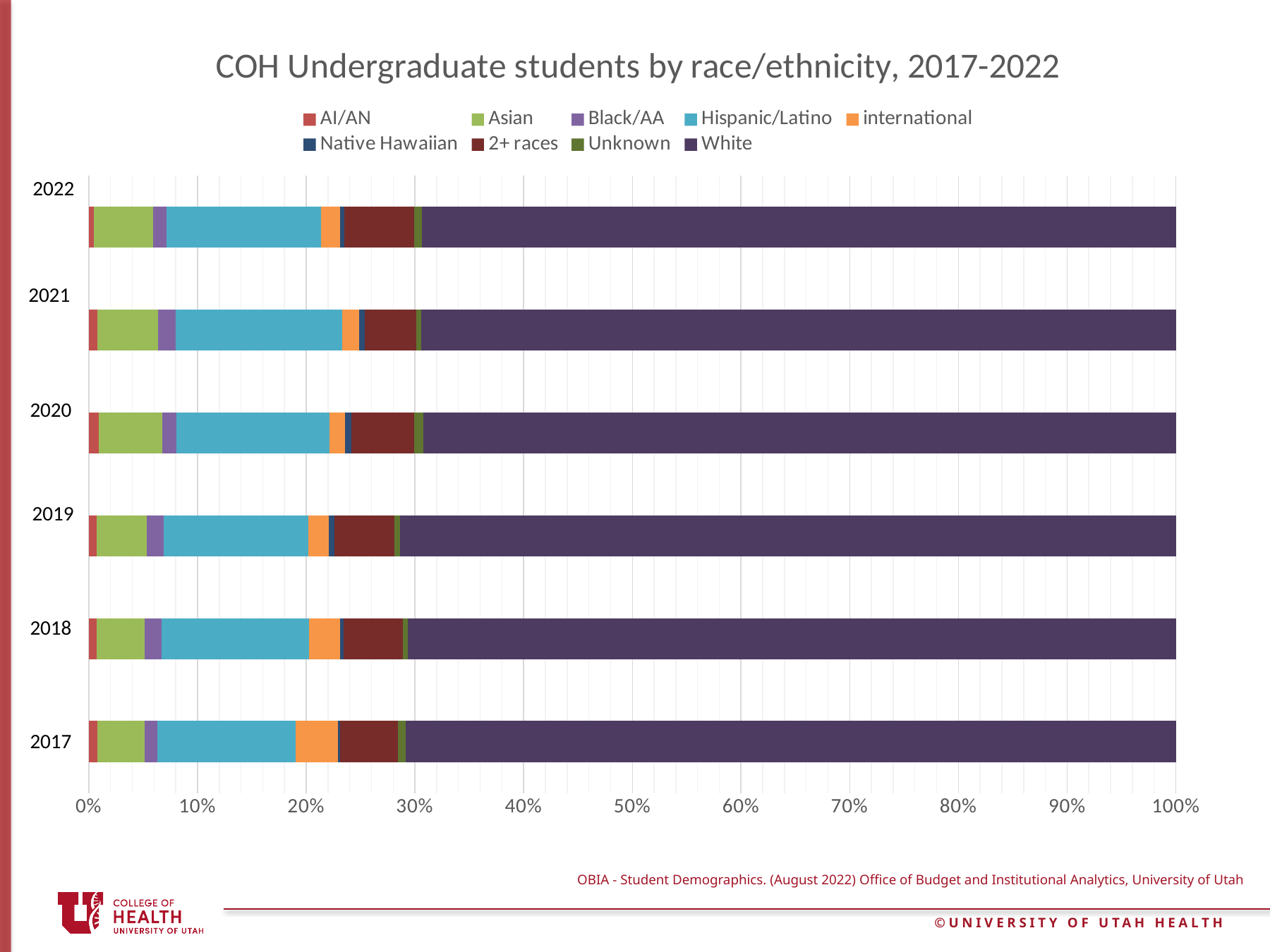
How many series does the legend list? 9 What does each full stacked bar total on the x axis? 100% What is the highest value shown on the x axis? 100% How many years (categories) are plotted on the chart? 6 Which race/ethnicity group has the largest share of students in 2022? White In 2022, which is larger: the share of Asian students or the share of Black/AA students? Asian What is the title of the chart? COH Undergraduate students by race/ethnicity, 2017-2022 What kind of chart is shown on the slide? Stacked bar chart Is the share of White students in 2022 greater or less than 60%? greater In 2017, which is larger: the share of White students or the share of Hispanic/Latino students? White Is the share of Hispanic/Latino students in 2022 greater or less than 10%? greater Is the share of Asian students in 2022 greater or less than 10%? less